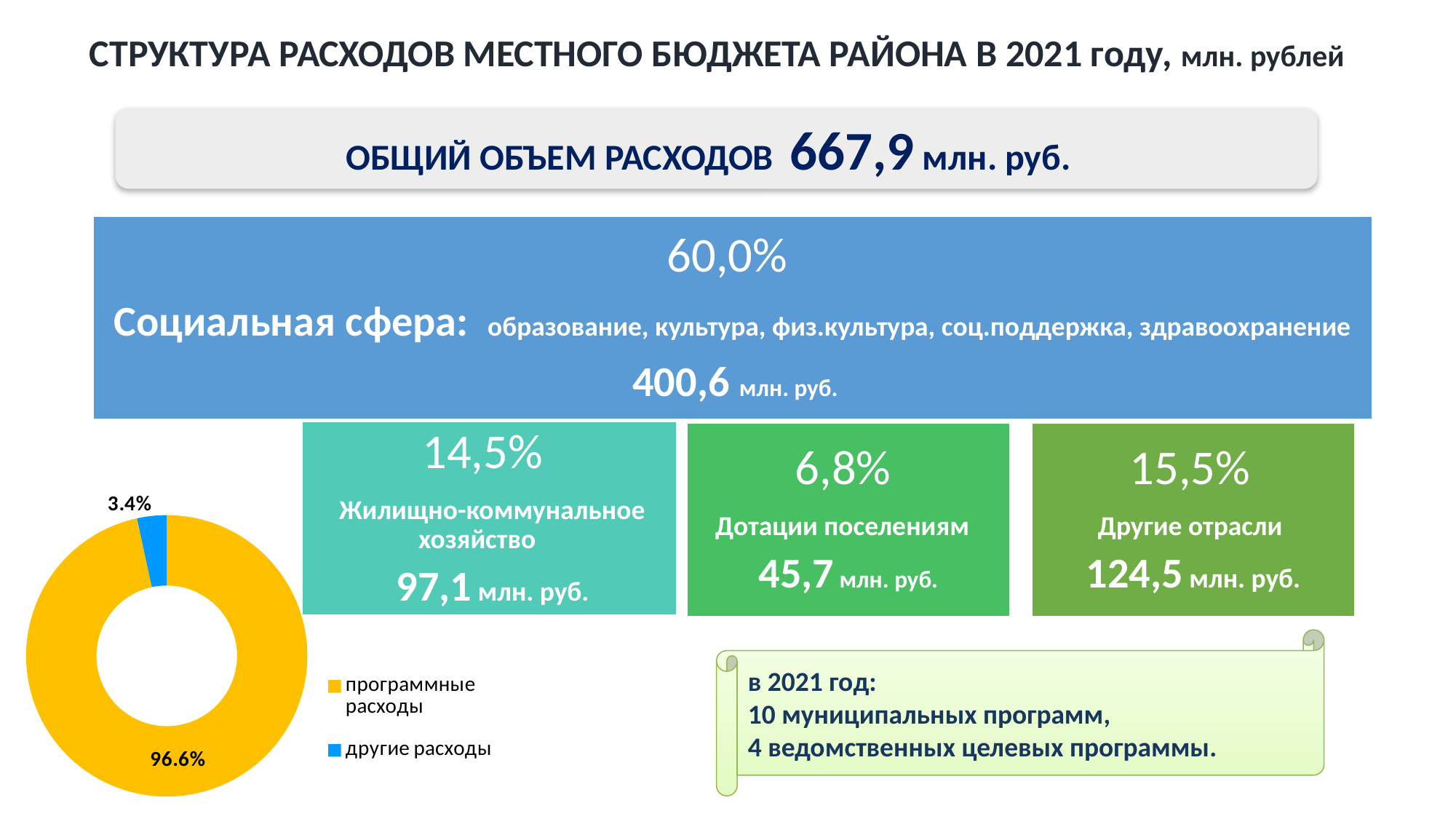
Is the share for "другие расходы" in the doughnut chart greater or less than 10%? less What colour is the "программные расходы" slice in the doughnut chart? yellow How many slices does the doughnut chart have? 2 What share of the doughnut chart is labelled "другие расходы"? 3.4% What type of chart is shown at the bottom left of the slide? doughnut (pie) chart How many entries does the legend of the doughnut chart list? 2 Which category has the largest slice in the doughnut chart? программные расходы By how many percentage points does "программные расходы" exceed "другие расходы" in the doughnut chart? 93.2 What share of the doughnut chart is labelled "программные расходы"? 96.6% Which category has the smallest slice in the doughnut chart? другие расходы What colour is the "другие расходы" slice in the doughnut chart? blue In the doughnut chart, which is larger: "программные расходы" or "другие расходы"? программные расходы